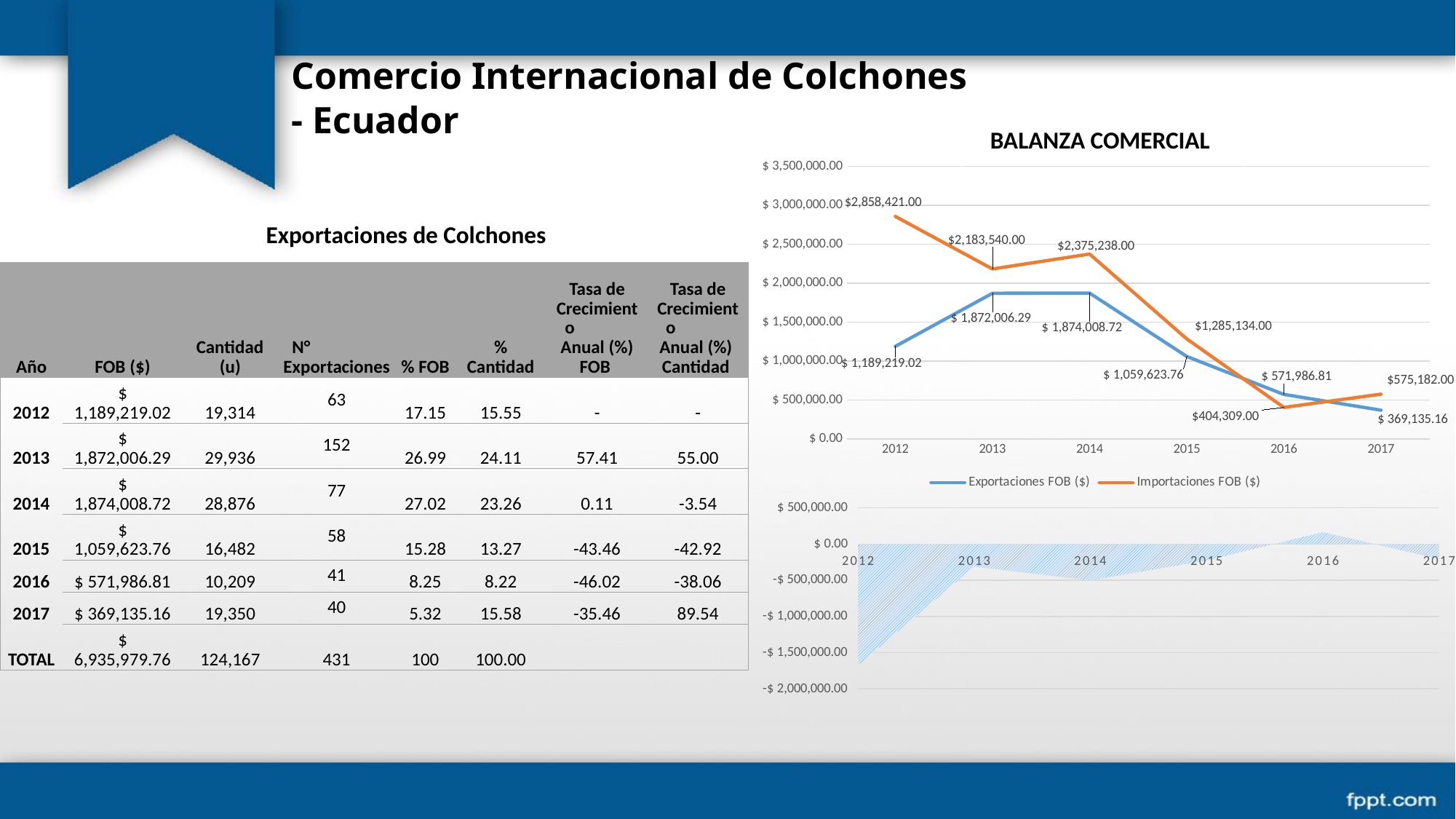
In the BALANZA COMERCIAL chart, which is larger in 2016: Exportaciones FOB ($) or Importaciones FOB ($)? Exportaciones FOB ($) In the BALANZA COMERCIAL chart, how many years are plotted on the x axis? 6 In the BALANZA COMERCIAL chart, which year has the highest Importaciones FOB ($)? 2012 In the BALANZA COMERCIAL chart, which year has the lowest Exportaciones FOB ($)? 2017 In the BALANZA COMERCIAL chart, how many series does the legend list? 2 In the BALANZA COMERCIAL chart, what is the value of Exportaciones FOB ($) in 2013? $ 1,872,006.29 In the BALANZA COMERCIAL chart, what is the difference between Importaciones FOB ($) and Exportaciones FOB ($) in 2012? $1,669,201.98 In the BALANZA COMERCIAL chart, what is the value of Importaciones FOB ($) in 2016? $404,309.00 In the BALANZA COMERCIAL chart, what is the value of Importaciones FOB ($) in 2014? $2,375,238.00 What kind of chart is the BALANZA COMERCIAL chart? Line chart In the BALANZA COMERCIAL chart, does Exportaciones FOB ($) rise or fall from 2014 to 2017? Fall In the lower area chart on the right, is the value for 2016 greater or less than $ 0.00? greater